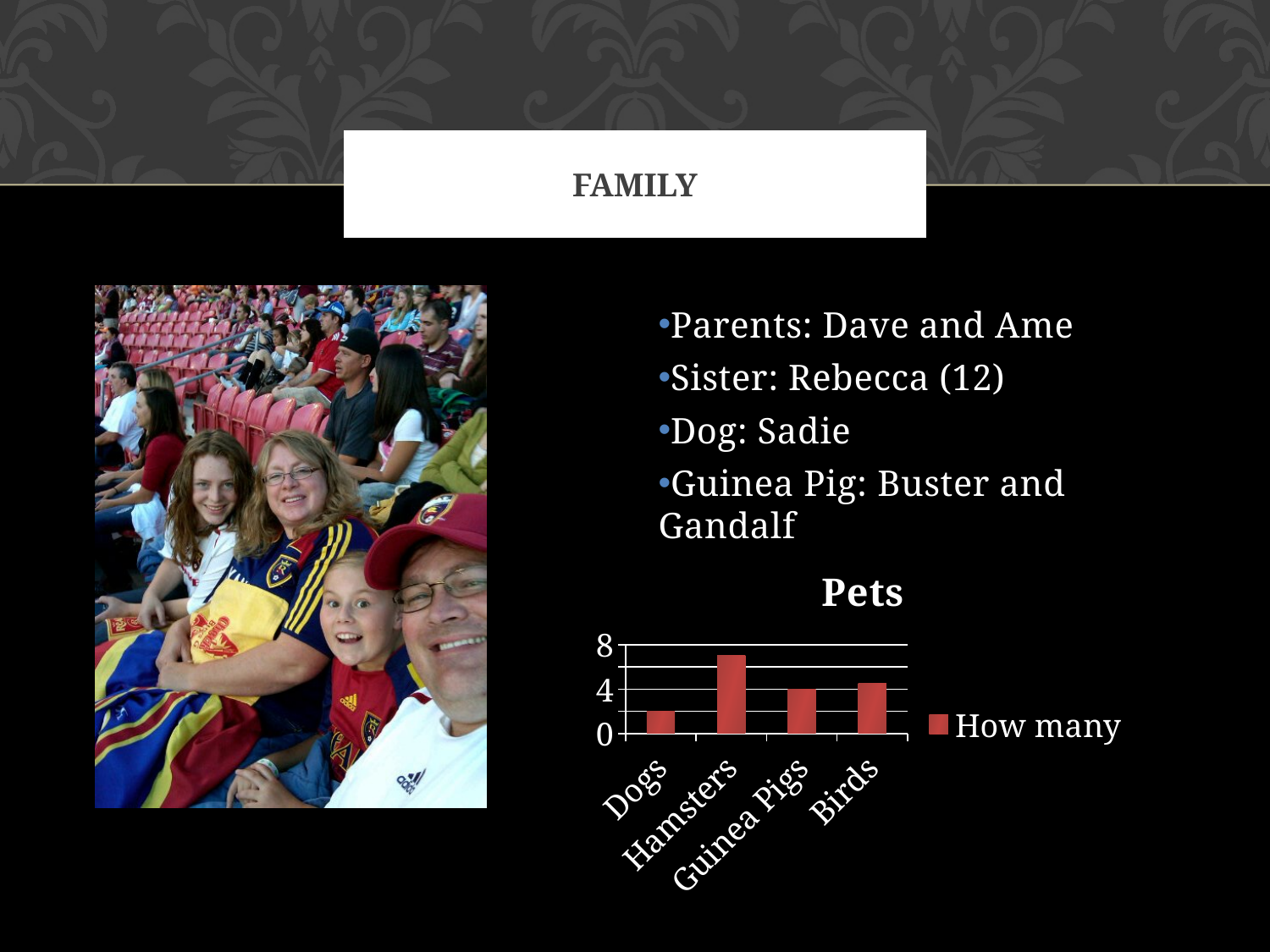
In the Pets chart, which is larger, the value for Birds or the value for Dogs? Birds In the Pets chart, which is larger, the value for Hamsters or the value for Dogs? Hamsters Which category has the lowest bar in the Pets chart? Dogs In the Pets chart, is the value for Hamsters greater or less than 4? greater What is the legend entry for the series in the Pets chart? How many What is the title of the chart on the slide? Pets In the Pets chart, is the value for Dogs greater or less than 4? less What kind of chart is the Pets chart? bar chart Which category has the highest bar in the Pets chart? Hamsters How many categories are shown on the x axis of the Pets chart? 4 How many series does the legend of the Pets chart list? 1 In the Pets chart, is the value for Hamsters greater or less than 8? less